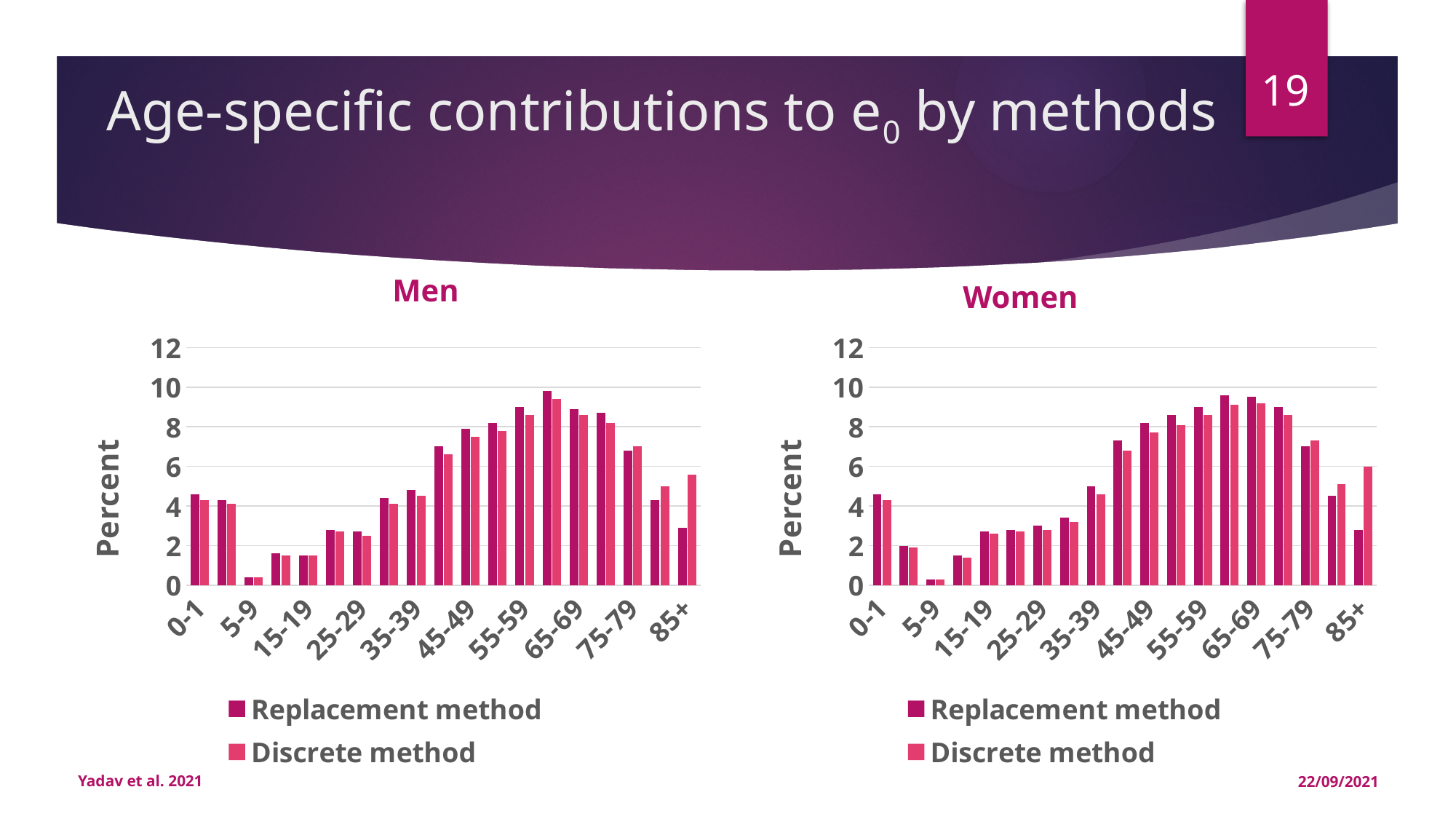
In the Men chart, do the Replacement method values generally rise or fall from 15-19 to 55-59? rise In the Women chart, is the Replacement method value for 15-19 greater or less than 2? greater How many series does the legend of the Women chart list? 2 In the Men chart, is the Replacement method value for 5-9 greater or less than 2? less In the Men chart, is the Replacement method value for 65-69 greater or less than 8? greater In the Women chart, for the 85+ age group, which series has the larger value: Replacement method or Discrete method? Discrete method What kind of chart is the Men chart? bar chart What is the y-axis label on the Women chart? Percent In the Men chart, which labelled age group has the lowest Replacement method value? 5-9 In the Women chart, which labelled age group has the lowest Discrete method value? 5-9 In the Men chart, which is larger: the Replacement method value for 45-49 or for 25-29? 45-49